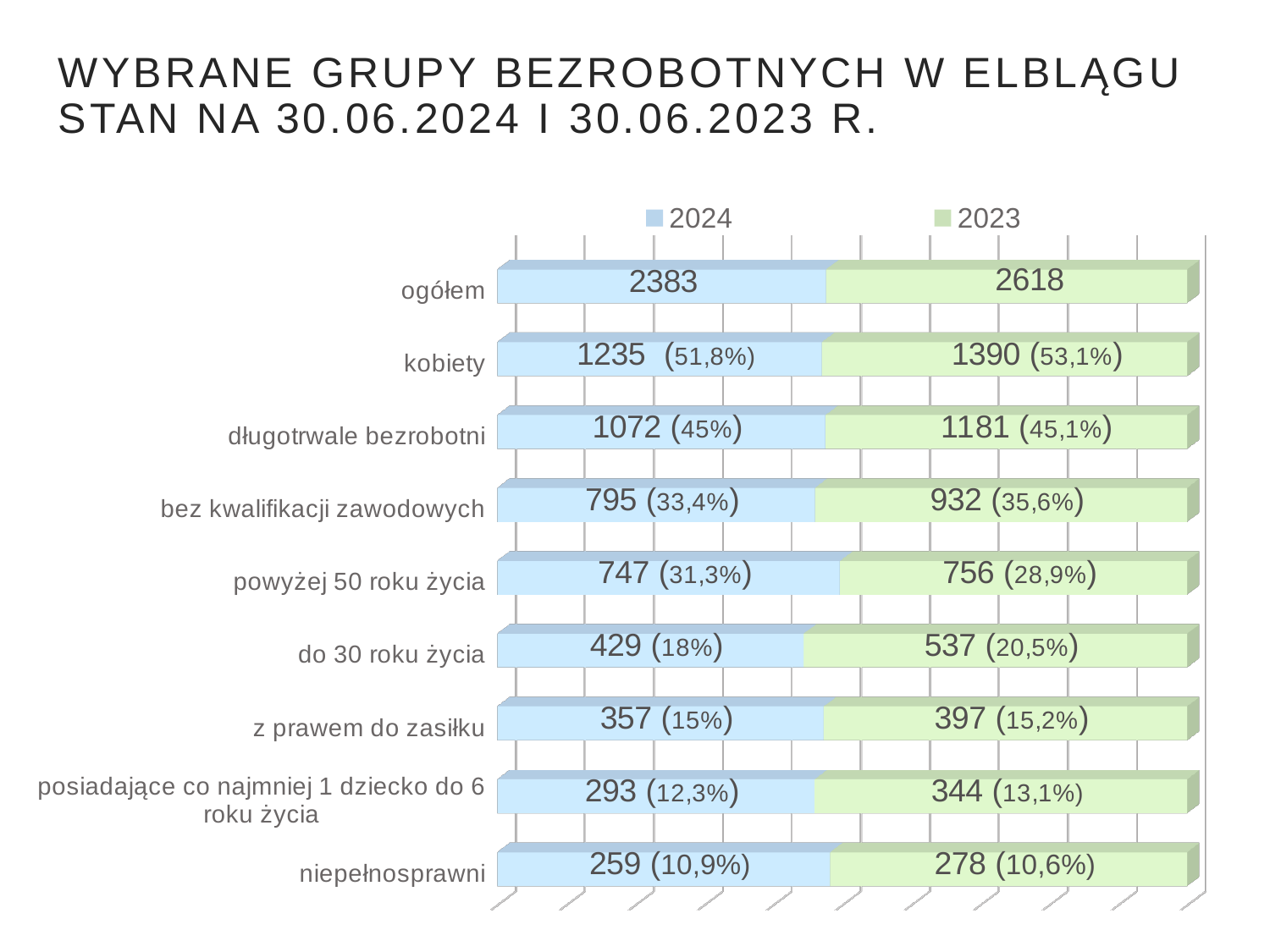
What is the 2024 value for "niepełnosprawni"? 259 What is the 2024 value for "ogółem"? 2383 What is the difference between the 2023 and 2024 values for "długotrwale bezrobotni"? 109 Which is larger for "z prawem do zasiłku": the 2024 value or the 2023 value? 2023 Excluding "ogółem", which category has the highest 2024 value? kobiety How many categories are shown on the chart? 9 What percentage is shown next to the 2023 value for "do 30 roku życia"? 20,5% Which category has the lowest 2023 value? niepełnosprawni How many series does the legend list? 2 What kind of chart is shown on the slide? bar chart What is the difference between the 2023 and 2024 values for "ogółem"? 235 What is the 2023 value for "kobiety"? 1390